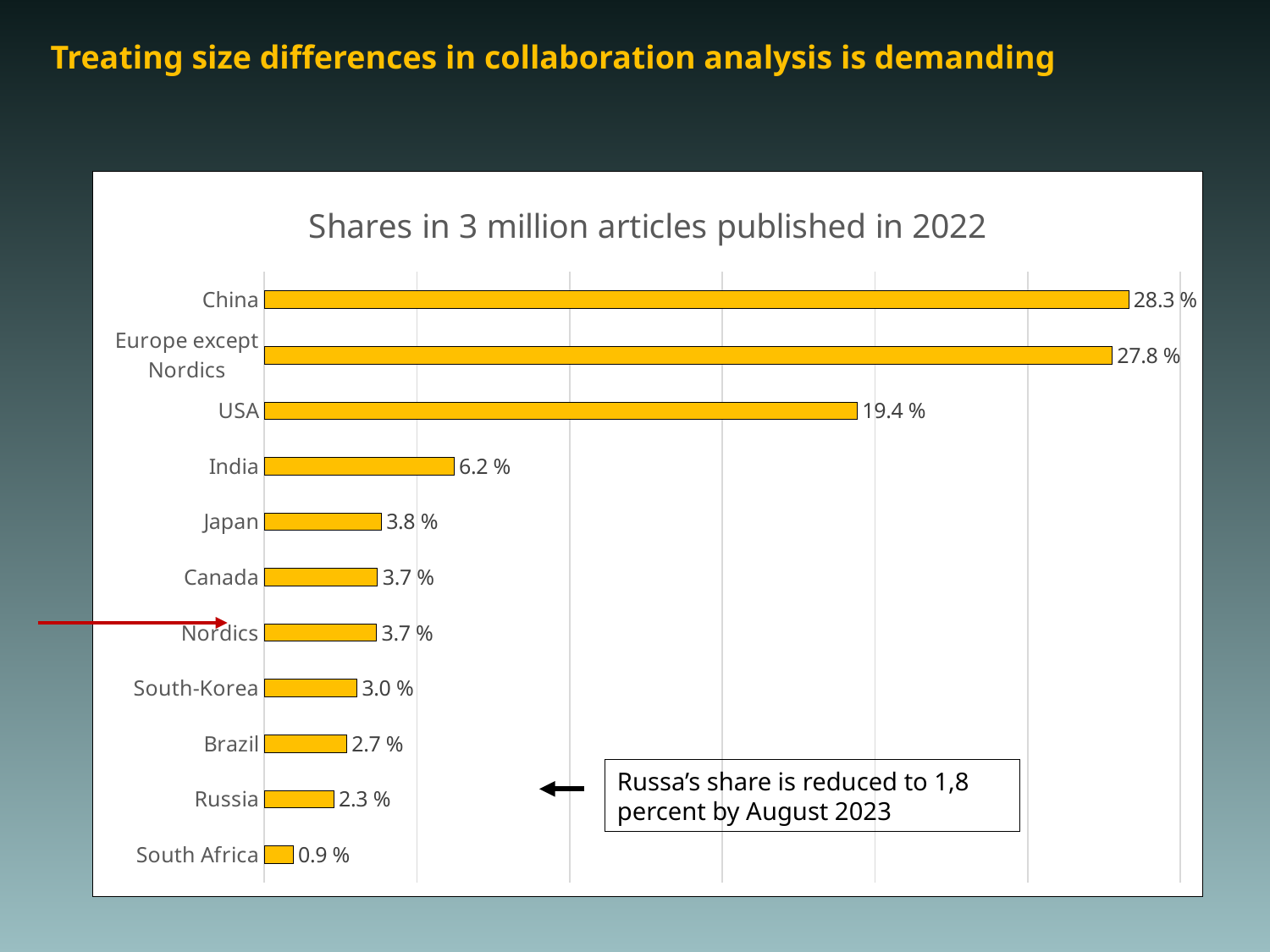
What is the share for Nordics? 3.7 % What is the difference between the shares of USA and India? 13.2 % What is the difference between the shares of China and Europe except Nordics? 0.5 % Which has a larger share, India or Japan? India How many categories are shown in the chart? 11 What is the share for Russia? 2.3 % What is the title of the chart? Shares in 3 million articles published in 2022 Which category has the highest share? China What is the share for USA? 19.4 % What is the share for China? 28.3 % Which category has the lowest share? South Africa What kind of chart is shown on the slide? Bar chart